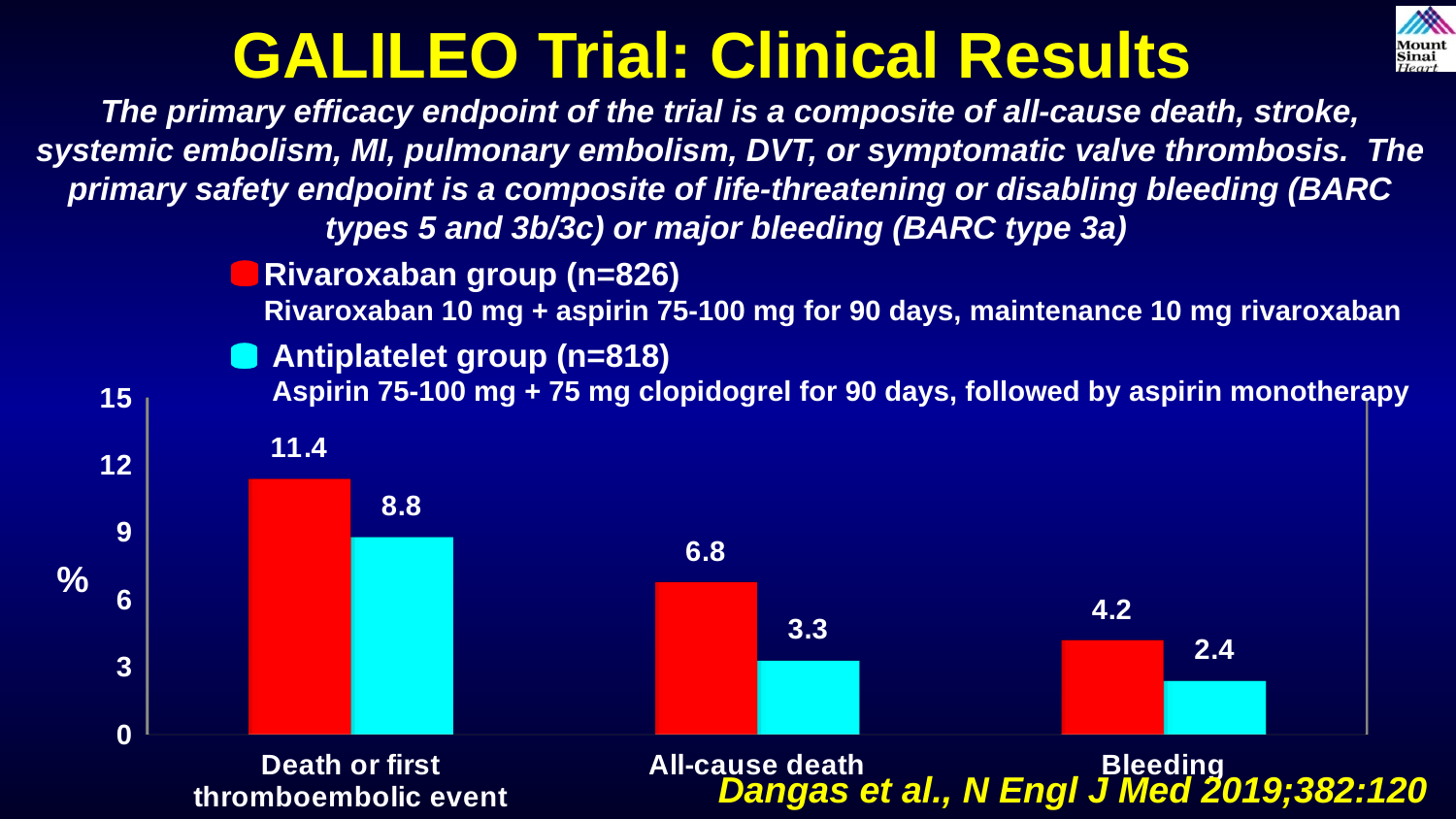
What is the value for the Antiplatelet group for Death or first thromboembolic event? 8.8 What colour represents the Antiplatelet group? Cyan How many categories are shown on the x axis? 3 Which group has the larger value for Bleeding, Rivaroxaban or Antiplatelet? Rivaroxaban group What is the value for the Rivaroxaban group for Bleeding? 4.2 What kind of chart is shown on the slide? Bar chart What is the value for the Rivaroxaban group for Death or first thromboembolic event? 11.4 What is the value for the Antiplatelet group for All-cause death? 3.3 Which category has the lowest value for the Antiplatelet group? Bleeding Which category has the highest value for the Rivaroxaban group? Death or first thromboembolic event How many series does the legend list? 2 What is the difference between the Rivaroxaban group and the Antiplatelet group for All-cause death? 3.5